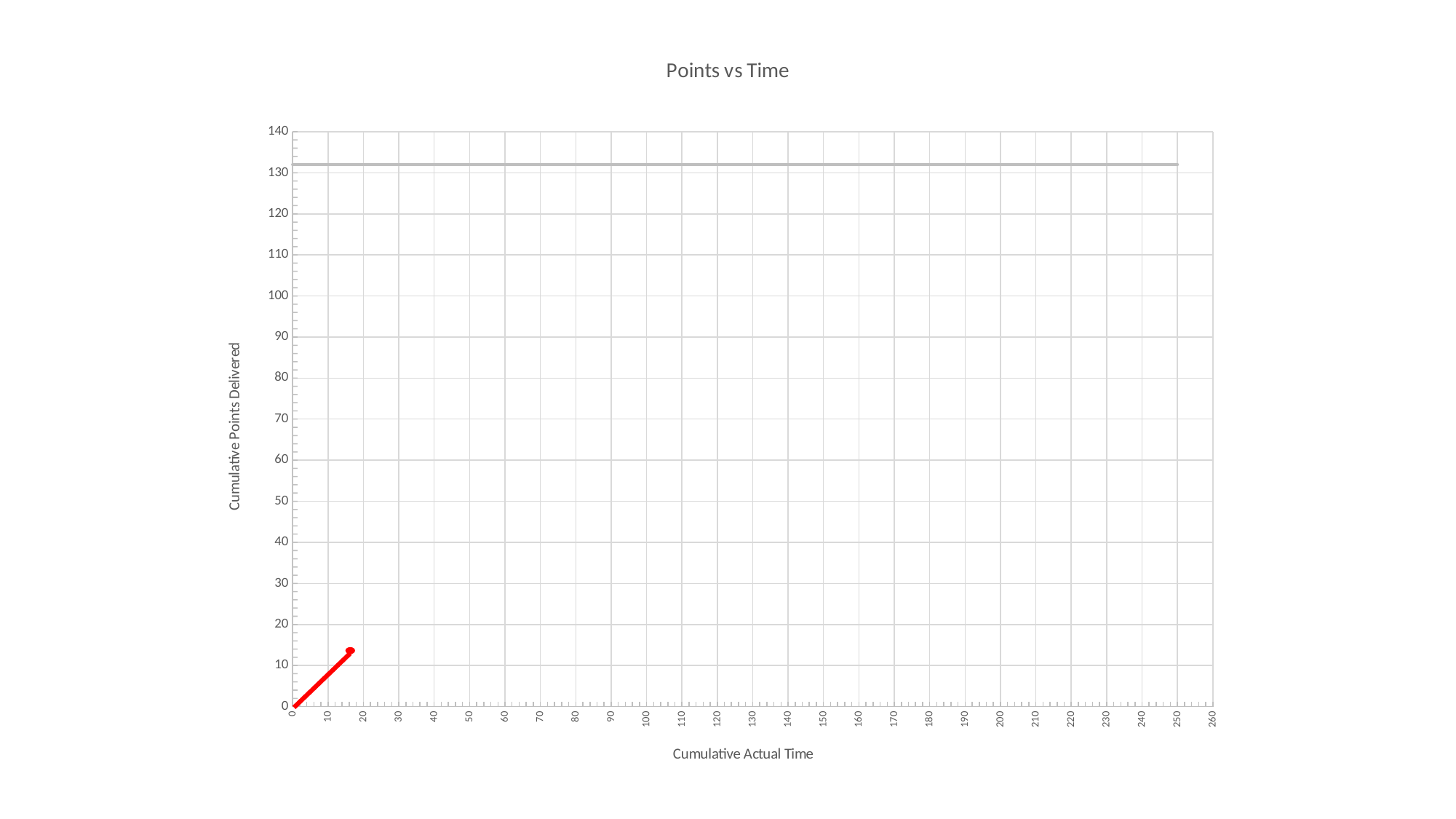
What is the highest tick value shown on the vertical axis? 140 Is the value of the gray horizontal line greater or less than 120? greater Is the value of the gray horizontal line greater or less than 140? less Does the red line rise or fall as Cumulative Actual Time increases? rise What kind of chart is shown on the slide? line chart What is the title of the chart? Points vs Time What is the label of the horizontal axis? Cumulative Actual Time Is the highest value reached by the red line greater or less than 20? less Does the gray horizontal line rise, fall, or stay flat across the chart? stay flat How many lines are plotted on the chart? 2